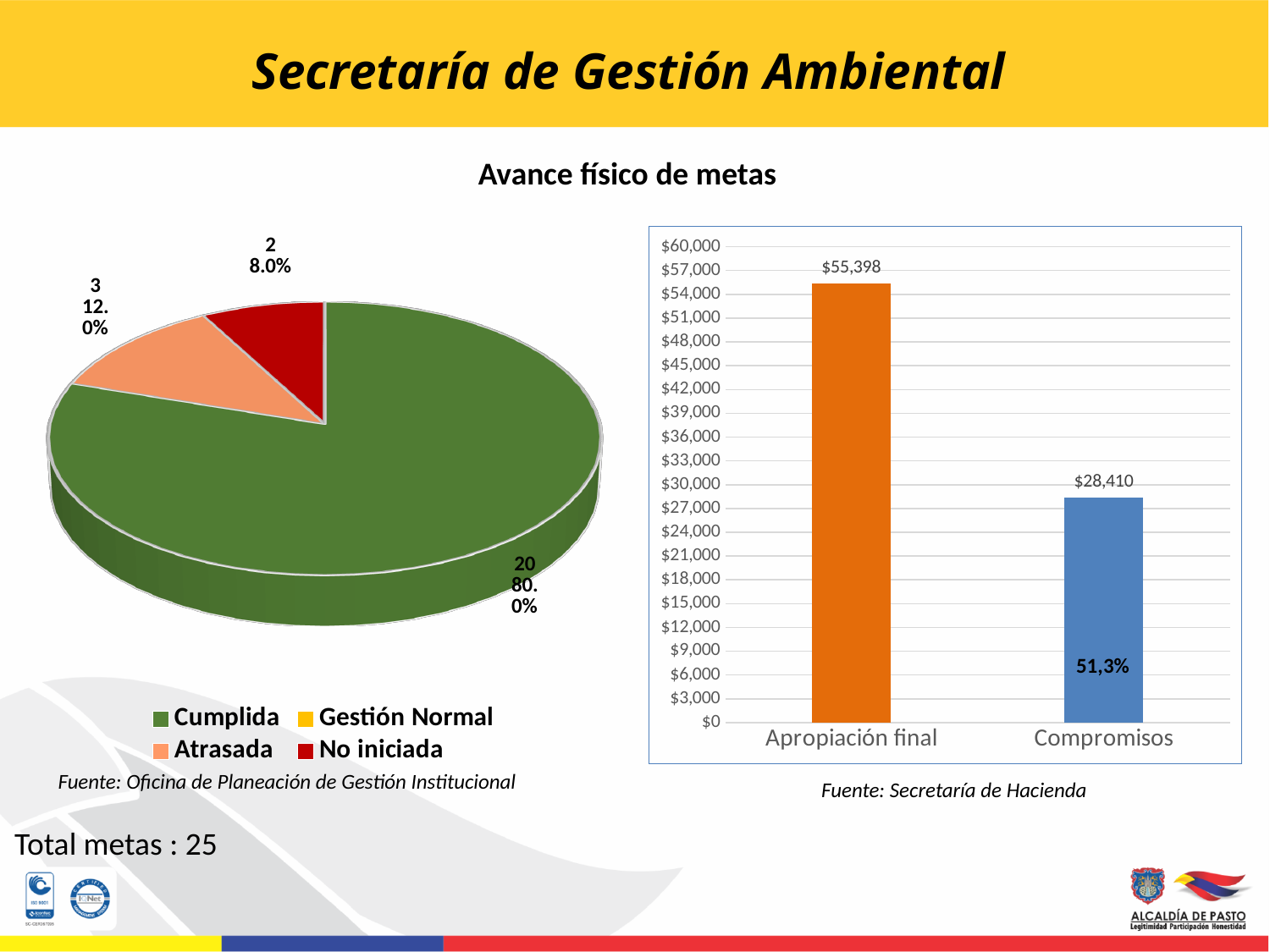
In the pie chart on the left, which category has the largest slice? Cumplida What kind of chart is the chart on the left of the slide? Pie chart In the pie chart on the left, how many metas are labelled No iniciada? 2 What kind of chart is the chart on the right of the slide? Bar chart How many entries does the legend of the pie chart on the left list? 4 In the pie chart on the left, what percentage share does the Cumplida slice have? 80.0% In the bar chart on the right, what is the value for Apropiación final? $55,398 In the pie chart on the left, what percentage share does the Atrasada slice have? 12.0% In the bar chart on the right, which is larger, Apropiación final or Compromisos? Apropiación final In the bar chart on the right, what is the difference between Apropiación final and Compromisos? $26,988 In the bar chart on the right, what is the value for Compromisos? $28,410 In the pie chart on the left, how many metas are labelled Cumplida? 20